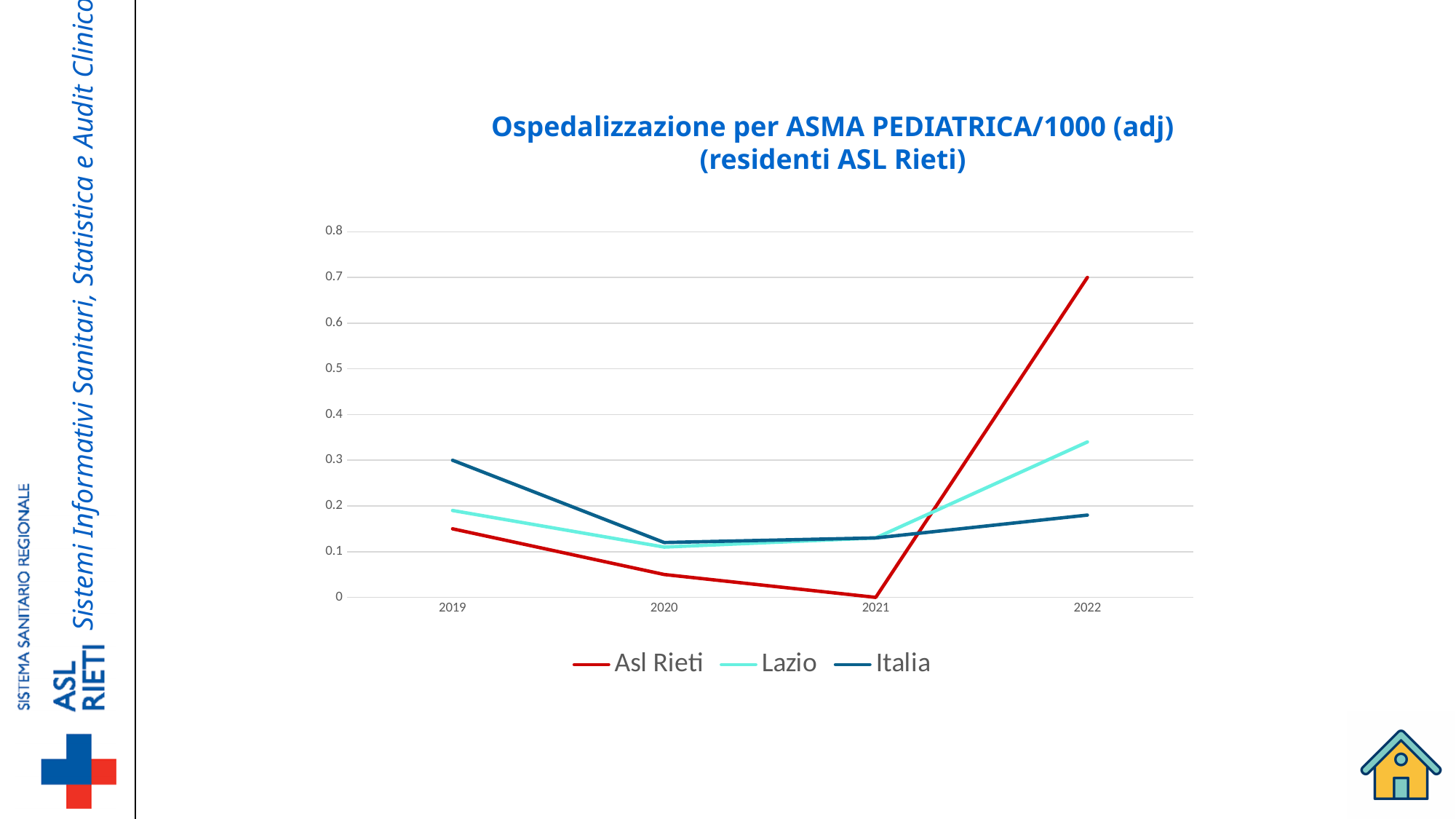
How many series does the legend list? 3 What is the value for Italia in 2019? 0.3 What is the value for Asl Rieti in 2021? 0 Which series has the lowest value in 2021? Asl Rieti Does the Asl Rieti line rise or fall from 2019 to 2021? fall Which series has the highest value in 2022? Asl Rieti Is the value for Lazio in 2022 greater or less than 0.3? greater Which series is drawn in red? Asl Rieti How many years are shown on the x axis? 4 What is the value for Asl Rieti in 2022? 0.7 In 2019, which is larger: the value for Italia or the value for Lazio? Italia What kind of chart is shown on the slide? line chart